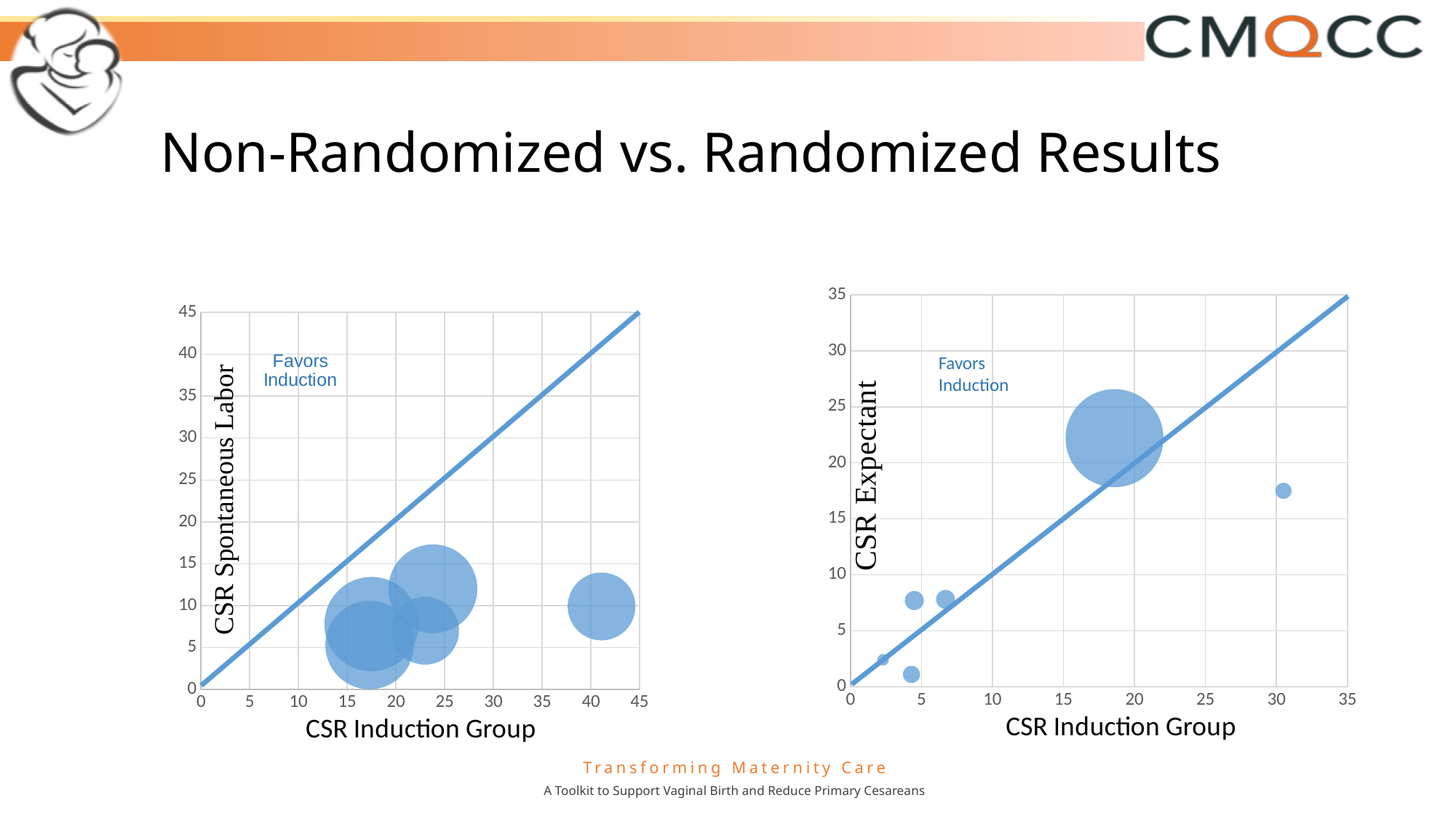
What kind of chart is the right chart on the slide? Bubble chart How many charts are shown on the slide? 2 In the right chart, how many bubbles are plotted? 6 In the left chart, what is the highest value shown on the vertical axis? 45 In the right chart, is the vertical-axis value of the bubble located furthest to the right (near 30 on the horizontal axis) greater or less than 20? less In the right chart, what is the highest value shown on the horizontal axis? 35 In the left chart, are the plotted bubbles above or below the diagonal line? Below In the left chart, what is the title of the vertical axis? CSR Spontaneous Labor In the right chart, is the vertical-axis value of the largest bubble greater or less than 15? greater In the right chart, what is the title of the vertical axis? CSR Expectant What kind of chart is the left chart on the slide? Bubble chart In the left chart, is the vertical-axis value of the bubble located furthest to the right (near 40 on the horizontal axis) greater or less than 20? less